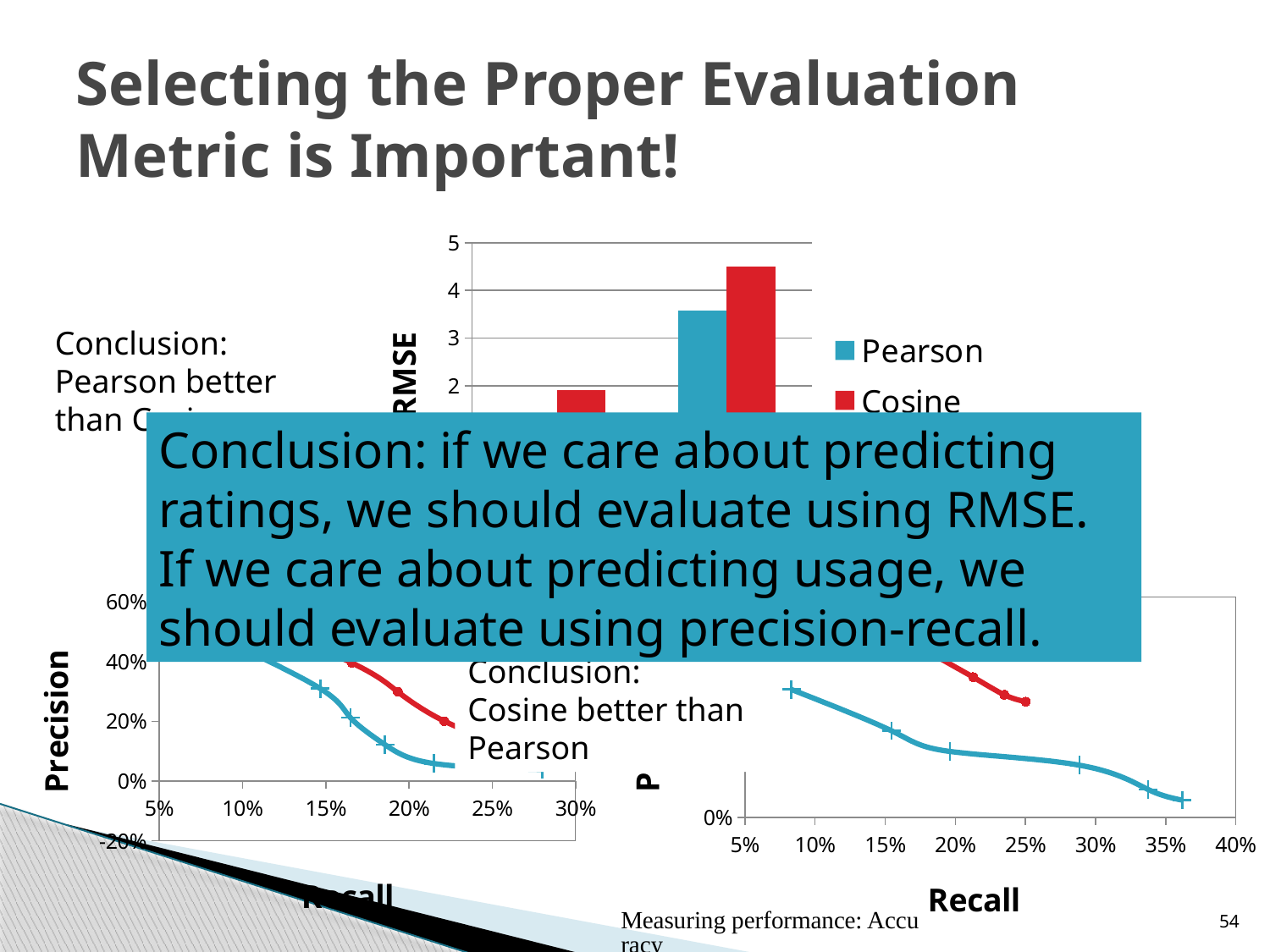
In the bottom-left Precision vs Recall chart, does the blue line rise or fall as recall increases? fall In the top RMSE bar chart, is the tallest Pearson bar greater or less than 4? less In the bottom-right chart with Recall on the x axis, does the blue line rise or fall as recall increases? fall What kind of chart is the bottom-left chart with Precision on the y axis and Recall on the x axis? line chart In the top RMSE bar chart, is the tallest Pearson bar greater or less than 3? greater In the bottom-left Precision vs Recall chart, which line is higher, the red line or the blue line? red line In the top RMSE bar chart, which series is shown in red? Cosine In the top RMSE bar chart, is the leftmost Cosine bar greater or less than 3? less What kind of chart is the top chart with the RMSE axis? bar chart How many series does the legend of the top RMSE bar chart list? 2 In the top RMSE bar chart, which series has the tallest bar overall? Cosine